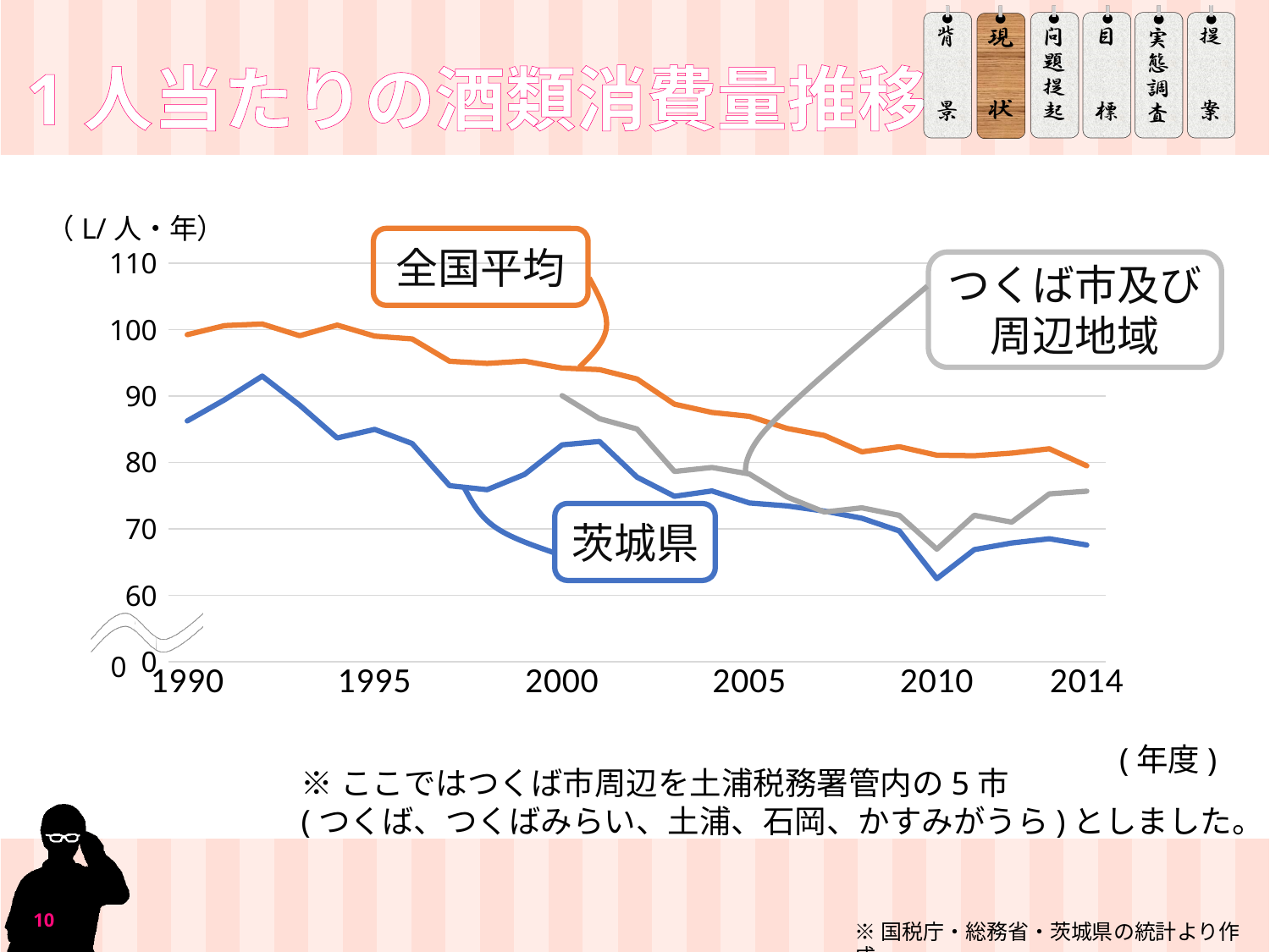
Does the 全国平均 line rise or fall from 1990 to 2014? fall What is the title of the slide's chart? 1人当たりの酒類消費量推移 Which series has the highest value in 2014? 全国平均 In 2000, which is larger: the value for 全国平均 or the value for 茨城県? 全国平均 Is the value for 茨城県 in 2010 greater or less than 70? less What kind of chart is shown on the slide? line chart Is the value for 全国平均 in 1990 greater or less than 90? greater How many series are plotted on the chart? 3 Is the value for 全国平均 in 2005 greater or less than 80? greater What unit is shown on the vertical axis of the chart? L/人・年 In 2014, which is larger: the value for つくば市及び周辺地域 or the value for 茨城県? つくば市及び周辺地域 Does the 茨城県 line rise or fall overall from 1990 to 2014? fall